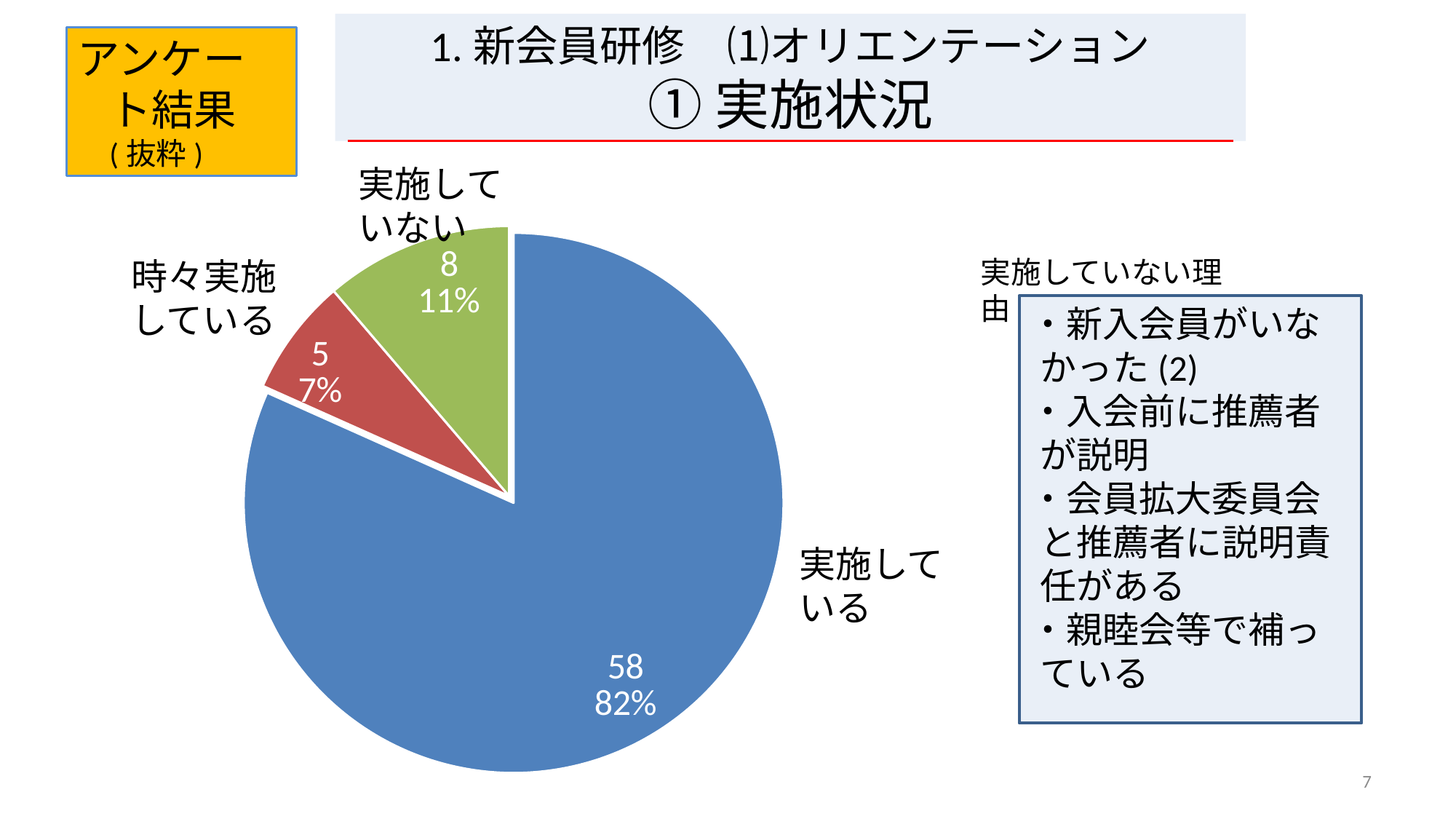
Which category has the smallest slice? 時々実施している How many slices does the pie chart have? 3 What is the count shown for 時々実施している? 5 Which is larger, the count for 実施していない or the count for 時々実施している? 実施していない What percentage of the pie is 実施している? 82% What is the difference in count between 実施している and 実施していない? 50 Which category has the largest slice? 実施している What kind of chart is shown on the slide? pie chart What is the count shown for 実施していない? 8 What is the count shown for 実施している? 58 What percentage of the pie is 実施していない? 11% What percentage of the pie is 時々実施している? 7%